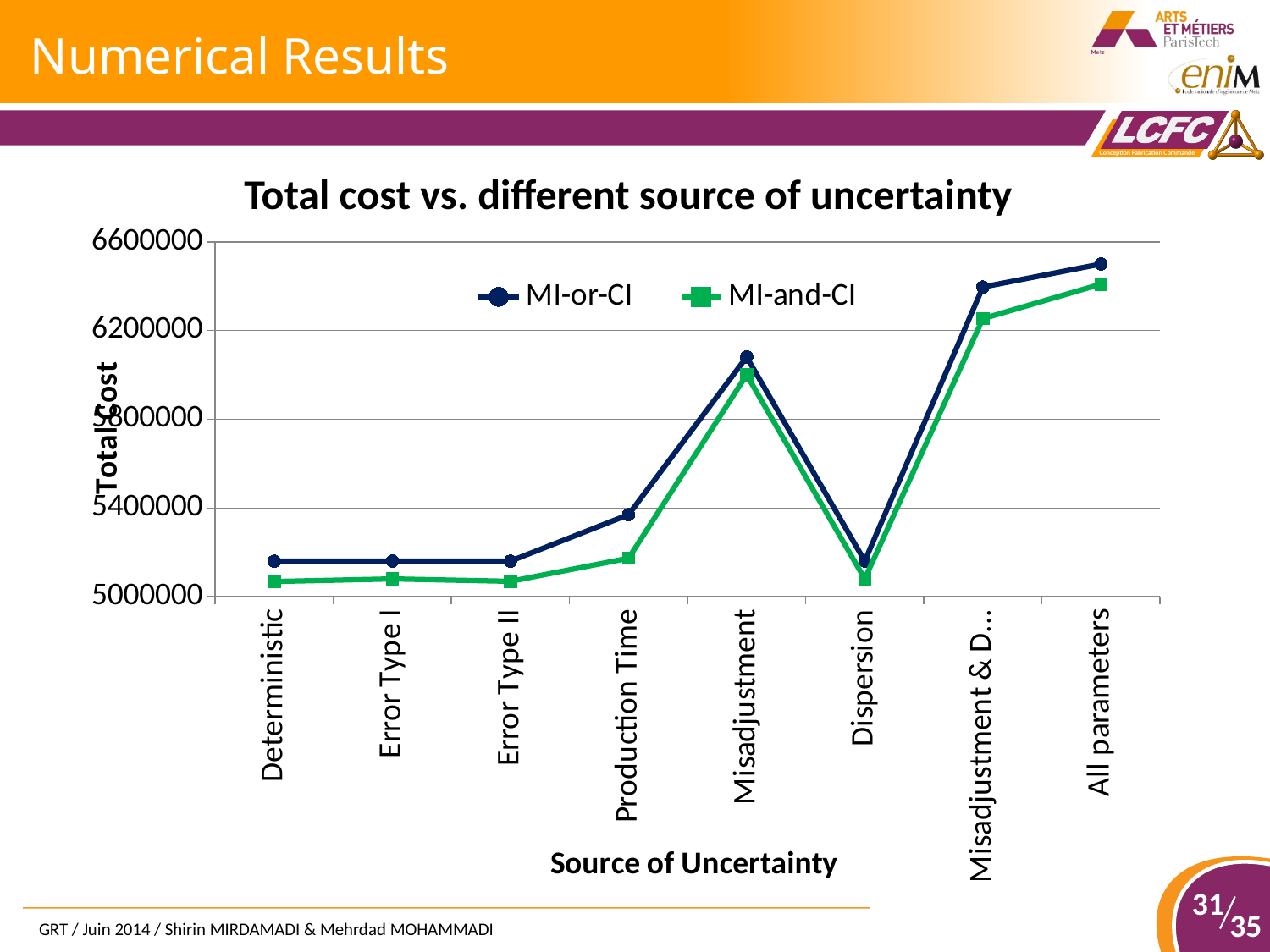
What is the title of the chart? Total cost vs. different source of uncertainty Is the MI-or-CI value for All parameters greater or less than 6200000? greater How many series does the legend list? 2 Is the MI-or-CI value for Dispersion greater or less than 5400000? less Which category has the highest value for the MI-or-CI series? All parameters Do the values rise or fall from Dispersion to All parameters for the MI-and-CI series? rise What kind of chart is shown on the slide? line chart At Production Time, which series has the larger value, MI-or-CI or MI-and-CI? MI-or-CI What is the label of the x axis? Source of Uncertainty Is the MI-or-CI value for Misadjustment greater or less than 5800000? greater How many categories are shown on the x axis? 8